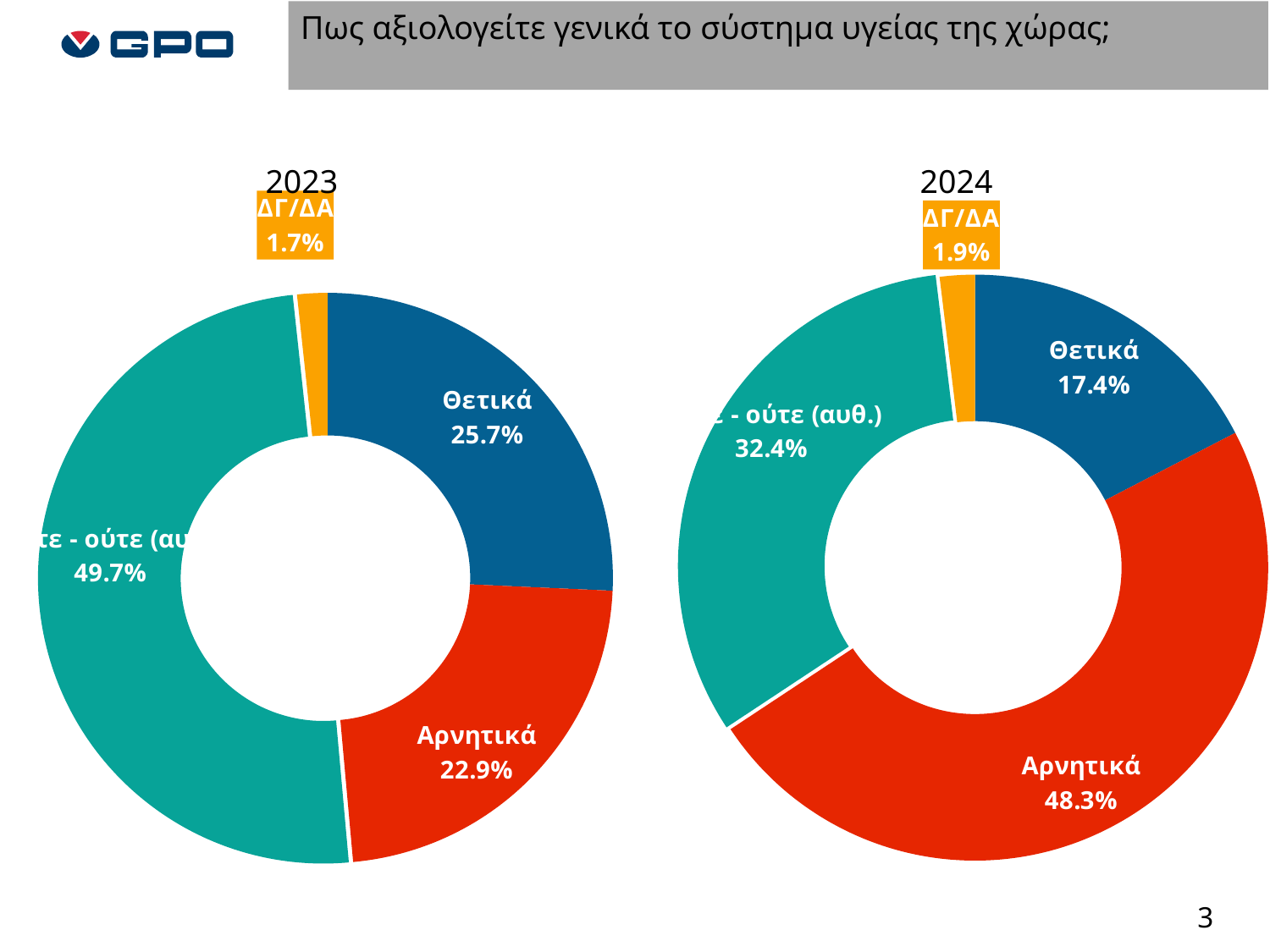
In the 2024 chart, which category has the largest share? Αρνητικά In the 2024 chart, what colour is the Αρνητικά slice? Red In the 2023 chart, which category has the smallest share? ΔΓ/ΔΑ How many slices does the 2024 chart have? 4 What is the difference between the Αρνητικά value in the 2024 chart and the Αρνητικά value in the 2023 chart? 25.4% In the 2024 chart, what is the value for Αρνητικά? 48.3% In the 2023 chart, which is larger, Θετικά or Αρνητικά? Θετικά In the 2024 chart, what is the difference between Αρνητικά and Θετικά? 30.9% In the 2023 chart, what is the value for Αρνητικά? 22.9% In the 2024 chart, what is the value for ΔΓ/ΔΑ? 1.9% What kind of chart is the 2023 chart? Donut (pie) chart In the 2023 chart, what is the value for Θετικά? 25.7%